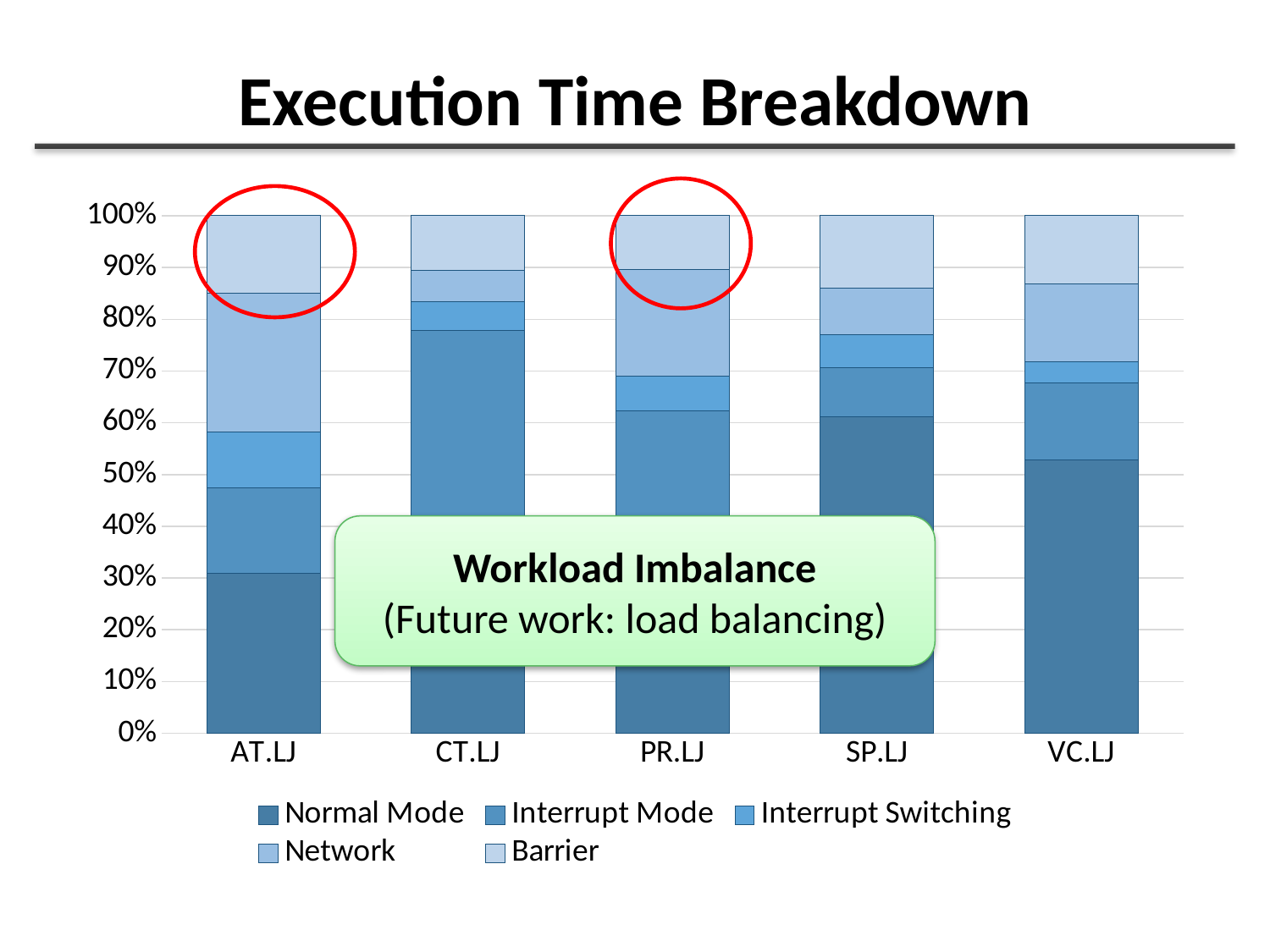
Is the Normal Mode value for VC.LJ greater or less than 60%? less Which series is listed first in the legend? Normal Mode Is the Normal Mode value for AT.LJ greater or less than 40%? less How many series does the legend list? 5 How many categories are shown on the x axis? 5 What is the total of the stacked bar for SP.LJ? 100% What is the title of the chart? Execution Time Breakdown Which category has the highest Normal Mode share? SP.LJ What kind of chart is shown on the slide? Stacked bar chart